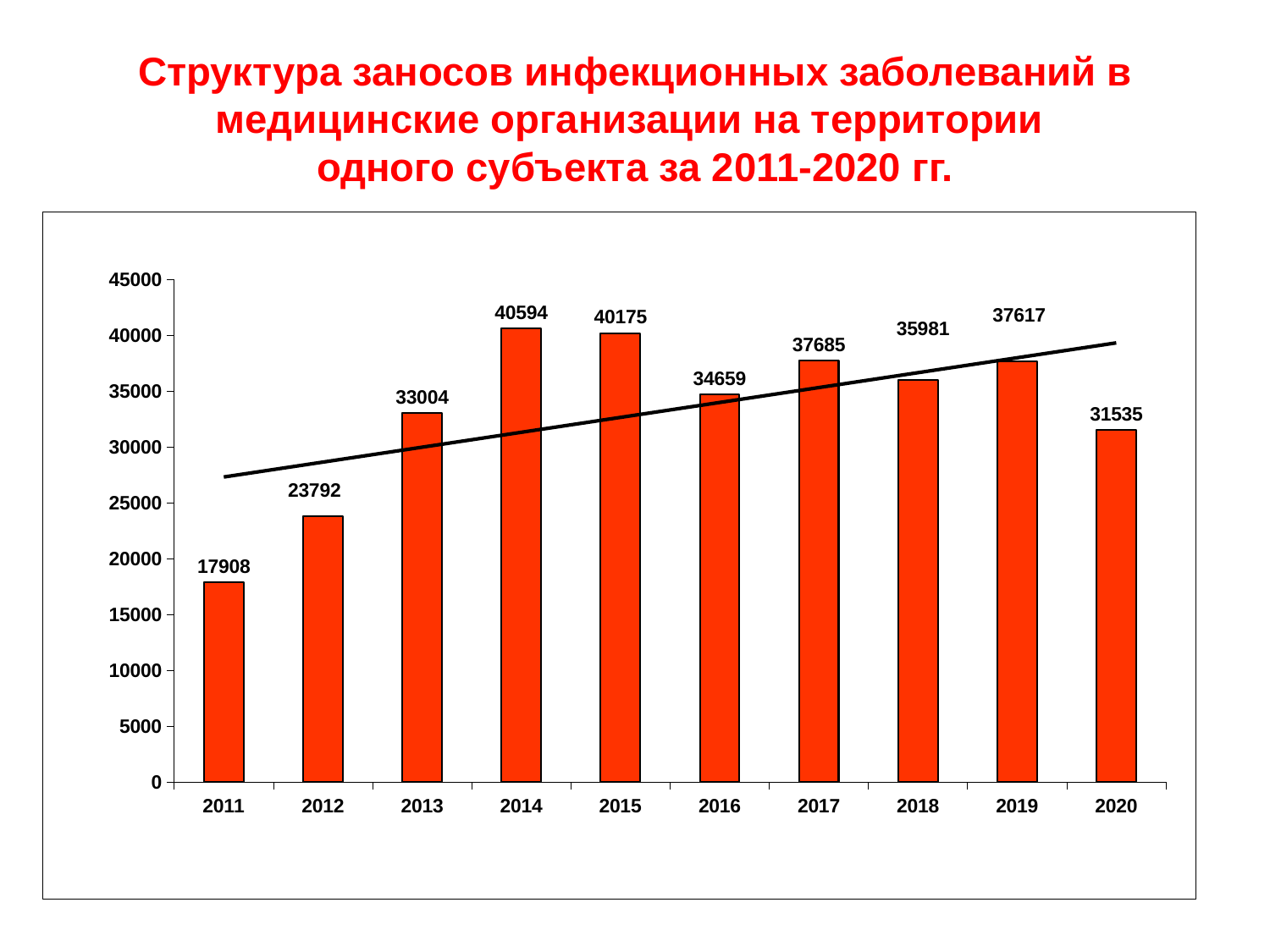
What is the value for 2011? 17908 Which is larger, the value for 2013 or the value for 2016? 2016 Does the trend line drawn across the chart rise or fall from left to right? rise What is the difference between the values for 2014 and 2011? 22686 Is the value for 2012 greater or less than 25000? less Which year has the lowest value? 2011 What is the value for 2020? 31535 Which year has the highest value? 2014 How many years are shown on the x axis? 10 What is the value for 2014? 40594 What kind of chart is this? bar chart What is the difference between the values for 2019 and 2020? 6082